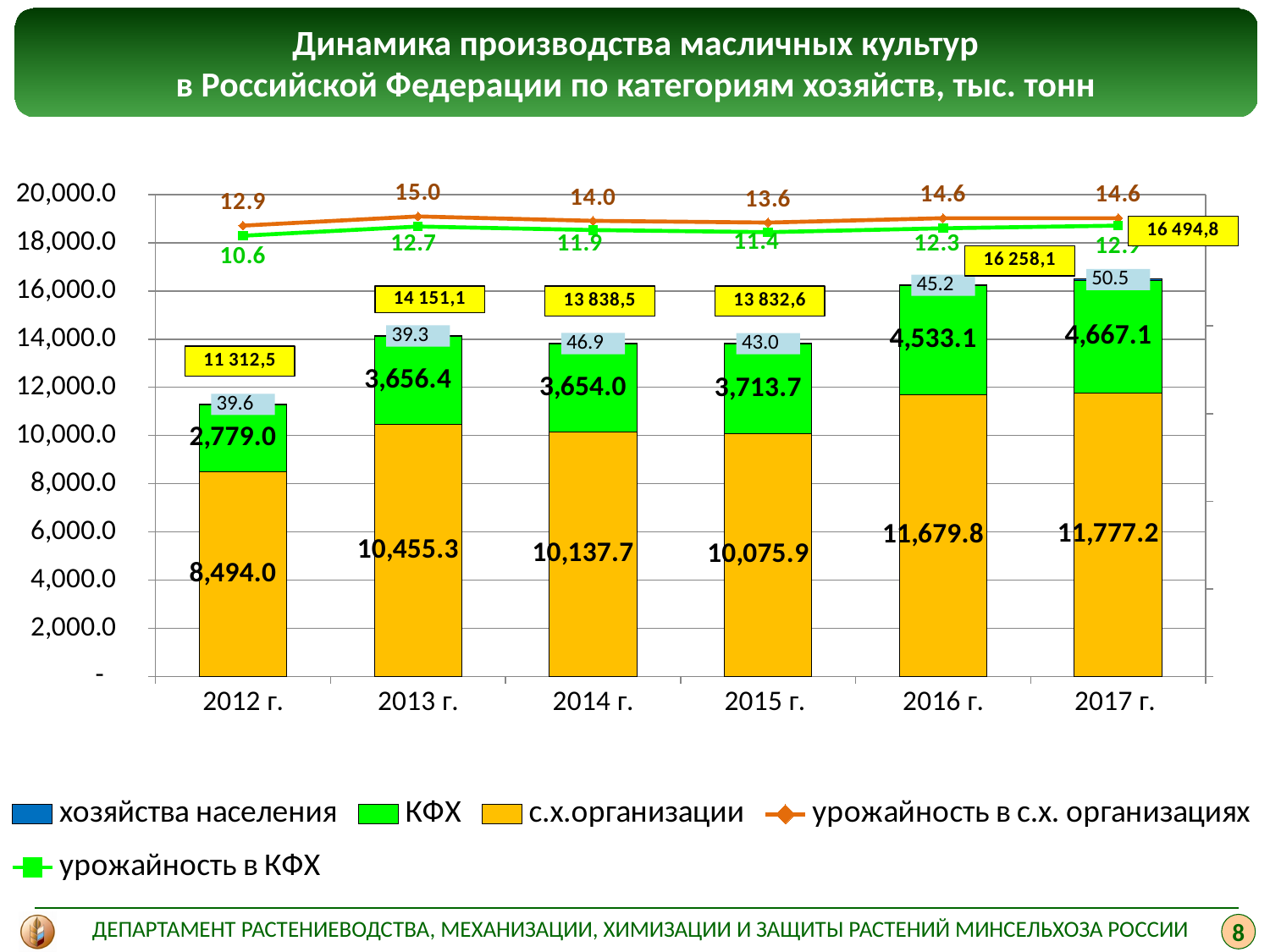
What is the value for хозяйства населения in 2014 г.? 46.9 What is the value for с.х.организации in 2012 г.? 8,494.0 What is the value of урожайность в с.х. организациях in 2013 г.? 15.0 What is the difference between the КФХ values in 2017 г. and 2016 г.? 134.0 In which year is the value for с.х.организации the highest? 2017 г. Does the value for с.х.организации rise or fall from 2015 г. to 2017 г.? rise Which is larger, the с.х.организации value in 2013 г. or in 2014 г.? 2013 г. What is the value for КФХ in 2017 г.? 4,667.1 What is the total of the stacked bar for 2016 г. as labelled on the chart? 16 258,1 How many years are shown on the x axis? 6 How many series does the legend list? 5 In which year is the value of урожайность в КФХ the lowest? 2012 г.